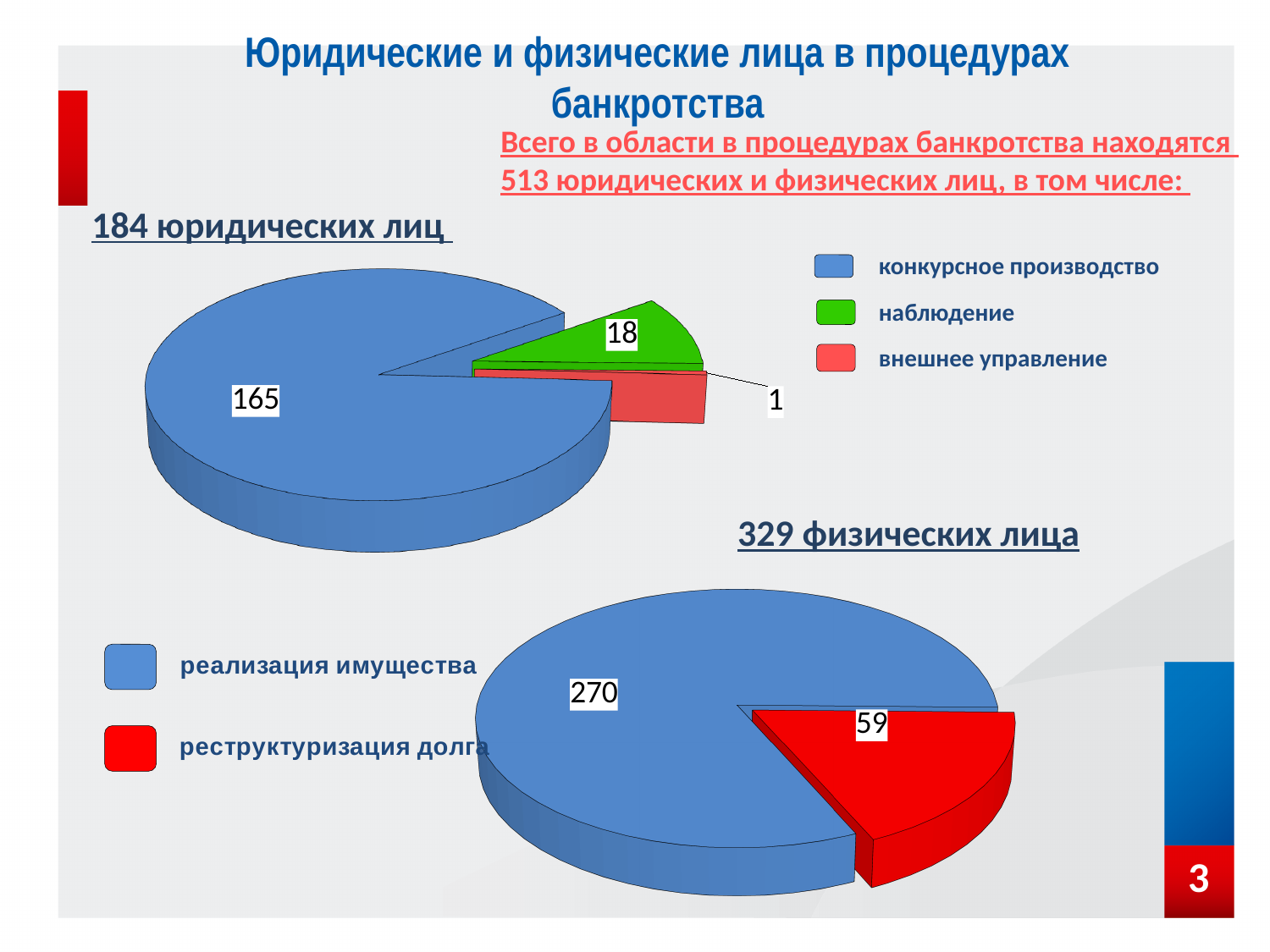
In the top pie chart (184 юридических лиц), which category has the largest value? конкурсное производство In the top pie chart (184 юридических лиц), which category has the smallest value? внешнее управление In the top pie chart (184 юридических лиц), what is the value for наблюдение? 18 In the top pie chart (184 юридических лиц), what is the value for внешнее управление? 1 In the top pie chart (184 юридических лиц), what is the difference between конкурсное производство and наблюдение? 147 In the bottom pie chart (329 физических лица), what is the value for реализация имущества? 270 In the bottom pie chart (329 физических лица), which is larger: реализация имущества or реструктуризация долга? реализация имущества In the top pie chart (184 юридических лиц), what is the value for конкурсное производство? 165 In the bottom pie chart (329 физических лица), what is the difference between реализация имущества and реструктуризация долга? 211 What type of chart is used for the 329 физических лица data? pie chart In the bottom pie chart (329 физических лица), what is the value for реструктуризация долга? 59 How many categories does the top pie chart (184 юридических лиц) show? 3